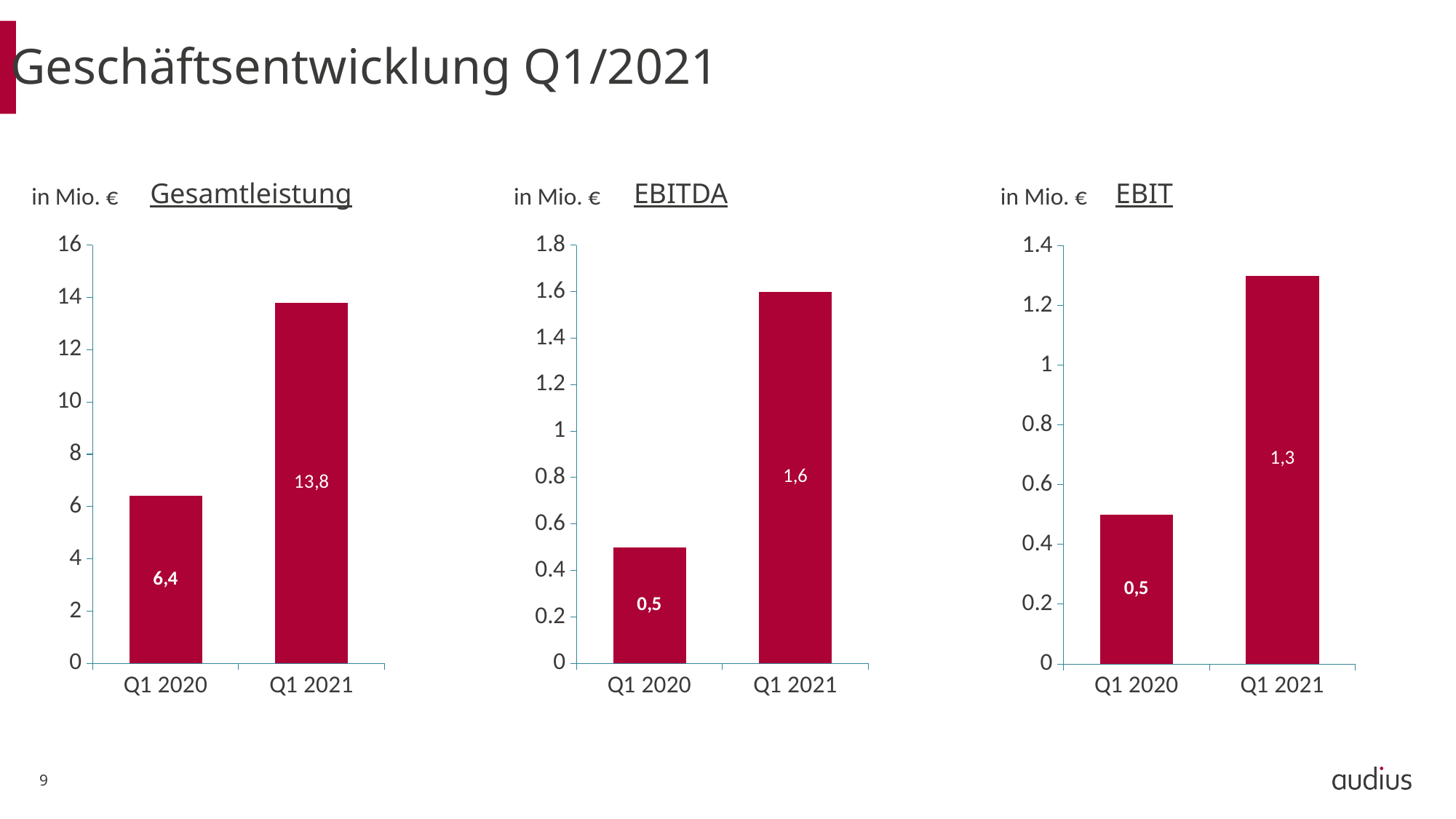
In the Gesamtleistung chart, is the value for Q1 2021 greater or less than 12? greater In the EBITDA chart, which quarter has the lowest value? Q1 2020 In the EBITDA chart, what is the difference between the Q1 2021 and Q1 2020 values? 1,1 In the EBIT chart, which quarter has the higher value? Q1 2021 In the EBITDA chart, what is the value for Q1 2021? 1,6 In the Gesamtleistung chart, what is the value for Q1 2021? 13,8 In the Gesamtleistung chart, what is the value for Q1 2020? 6,4 What kind of chart is the EBITDA chart? Bar chart In the Gesamtleistung chart, what is the difference between the Q1 2021 and Q1 2020 values? 7,4 In the EBIT chart, what is the value for Q1 2021? 1,3 How many categories are shown on the x axis of the EBIT chart? 2 In the EBIT chart, what is the value for Q1 2020? 0,5